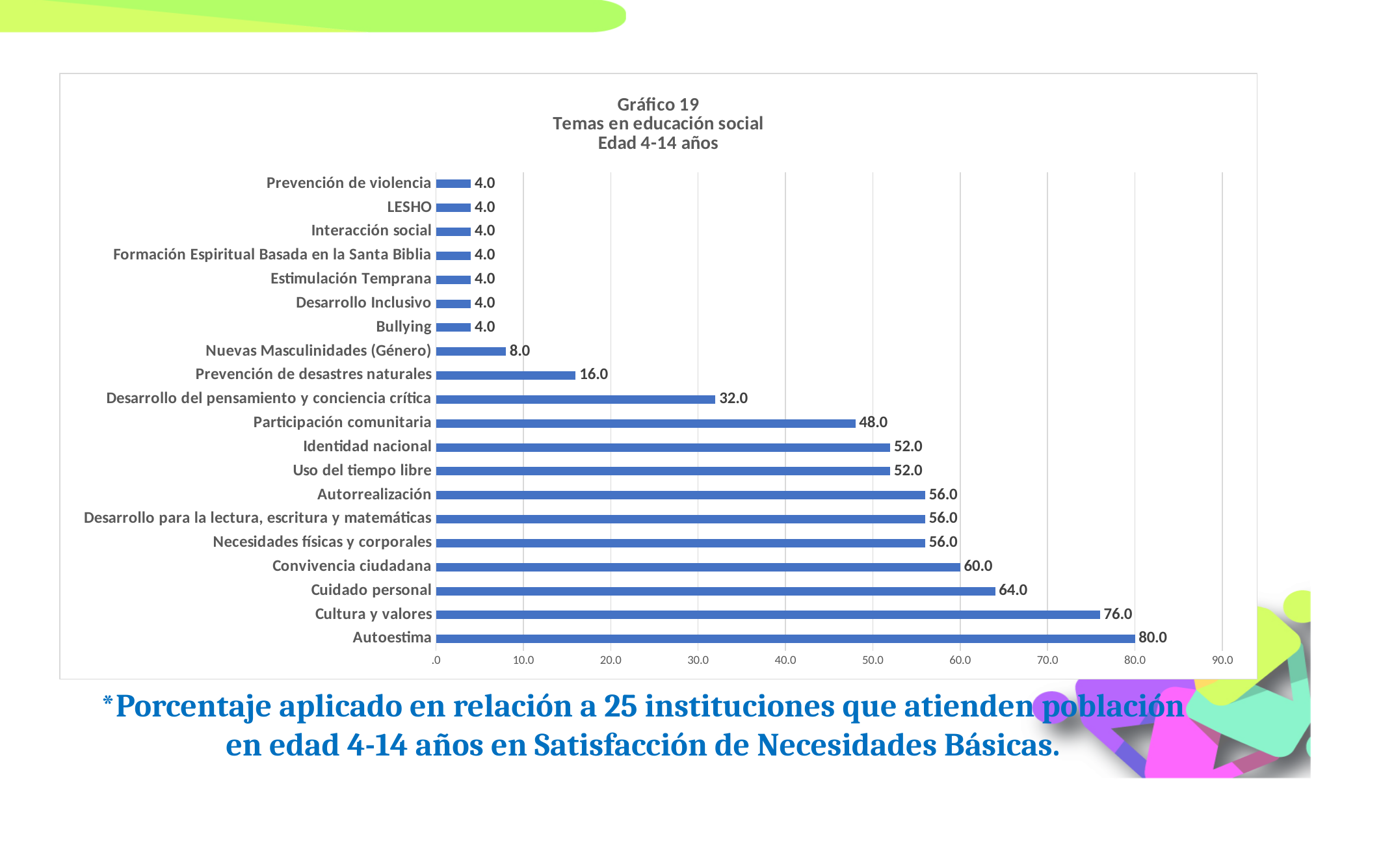
Is the value for Cuidado personal greater or less than 60.0? greater Which is larger, the value for Identidad nacional or the value for Desarrollo del pensamiento y conciencia crítica? Identidad nacional What is the difference between the values for Cultura y valores and Convivencia ciudadana? 16.0 What is the value for Participación comunitaria? 48.0 What is the lowest value shown on the chart? 4.0 How many categories are shown on the chart? 20 What is the value for Autoestima? 80.0 What is the value for Cuidado personal? 64.0 What is the title of the chart? Gráfico 19 Temas en educación social Edad 4-14 años What kind of chart is this? Bar chart What is the value for Prevención de desastres naturales? 16.0 Which category has the highest value? Autoestima